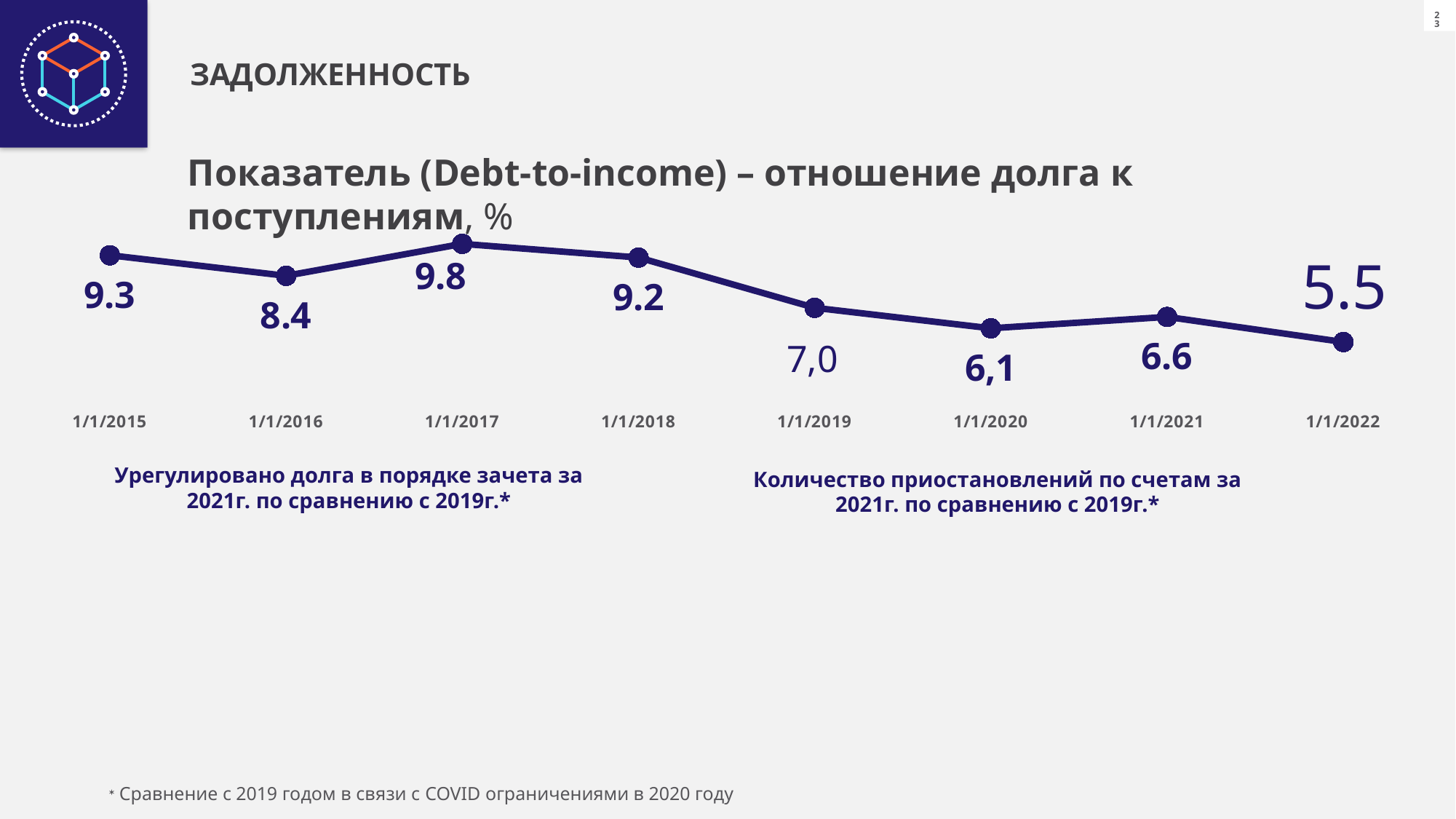
What is the value for 1/1/2021? 6.6 Which date has the lowest value? 1/1/2022 How many data points are plotted on the chart? 8 What kind of chart is shown on the slide? line chart What is the value for 1/1/2022? 5.5 What is the value for 1/1/2015? 9.3 Which is larger, the value for 1/1/2018 or the value for 1/1/2020? 1/1/2018 What is the difference between the values for 1/1/2017 and 1/1/2022? 4.3 What is the difference between the values for 1/1/2015 and 1/1/2016? 0.9 Do the values generally rise or fall from 1/1/2017 to 1/1/2022? fall Which date has the highest value? 1/1/2017 What is the value for 1/1/2019? 7,0